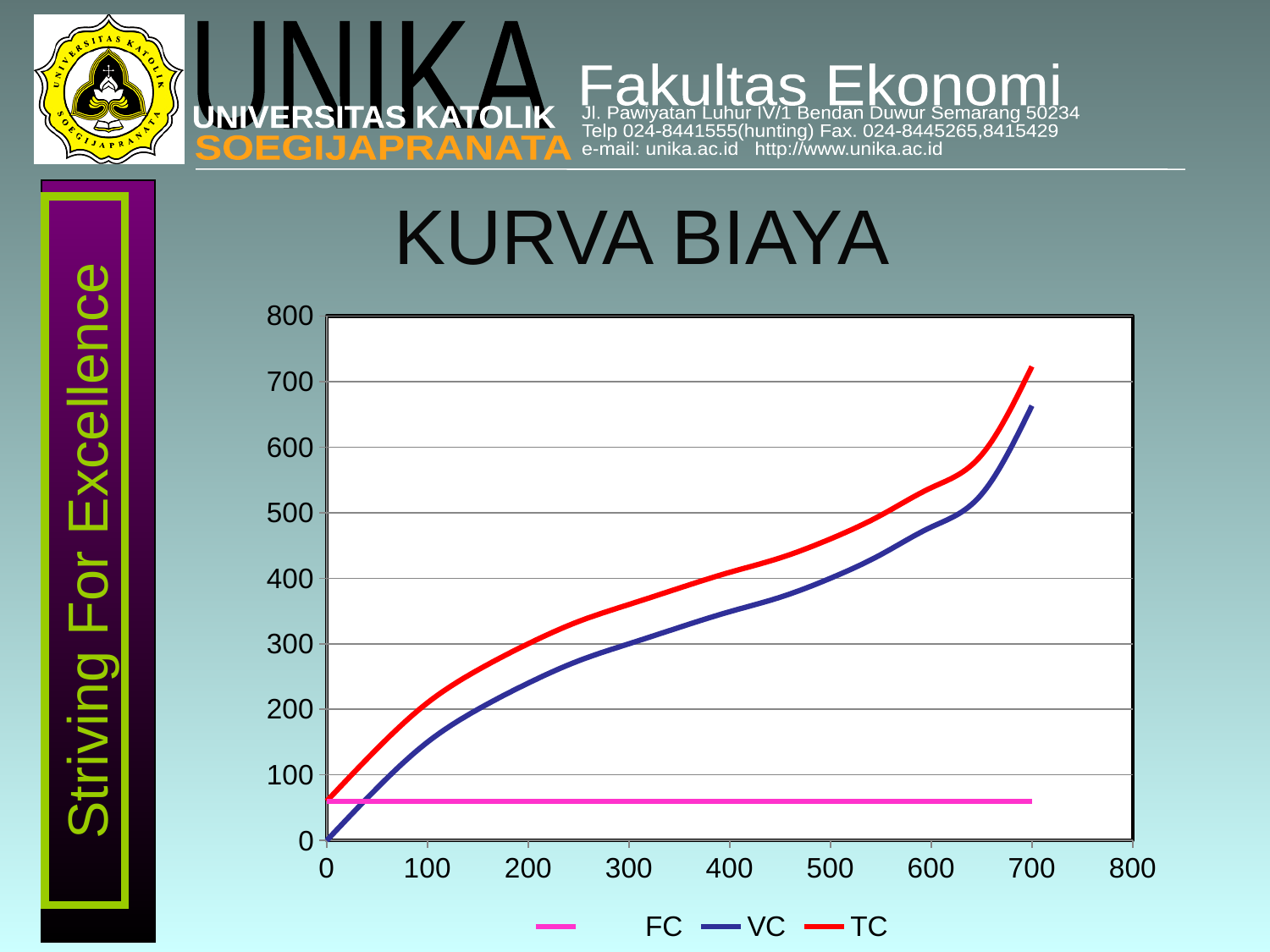
Is the value of VC at x = 700 greater or less than 700? less What is the value of VC at x = 0? 0 What kind of chart is shown on the slide? line chart Does the VC line rise or fall as x increases from 0 to 700? rise Which series has the lowest value at x = 700? FC Which colour is used for the TC line? red Is the value of FC greater or less than 100? less What is the title of the chart? KURVA BIAYA Is the value of TC at x = 600 greater or less than 500? greater Which series has the highest value at x = 700? TC How many series does the legend list? 3 At x = 400, which is larger, TC or VC? TC